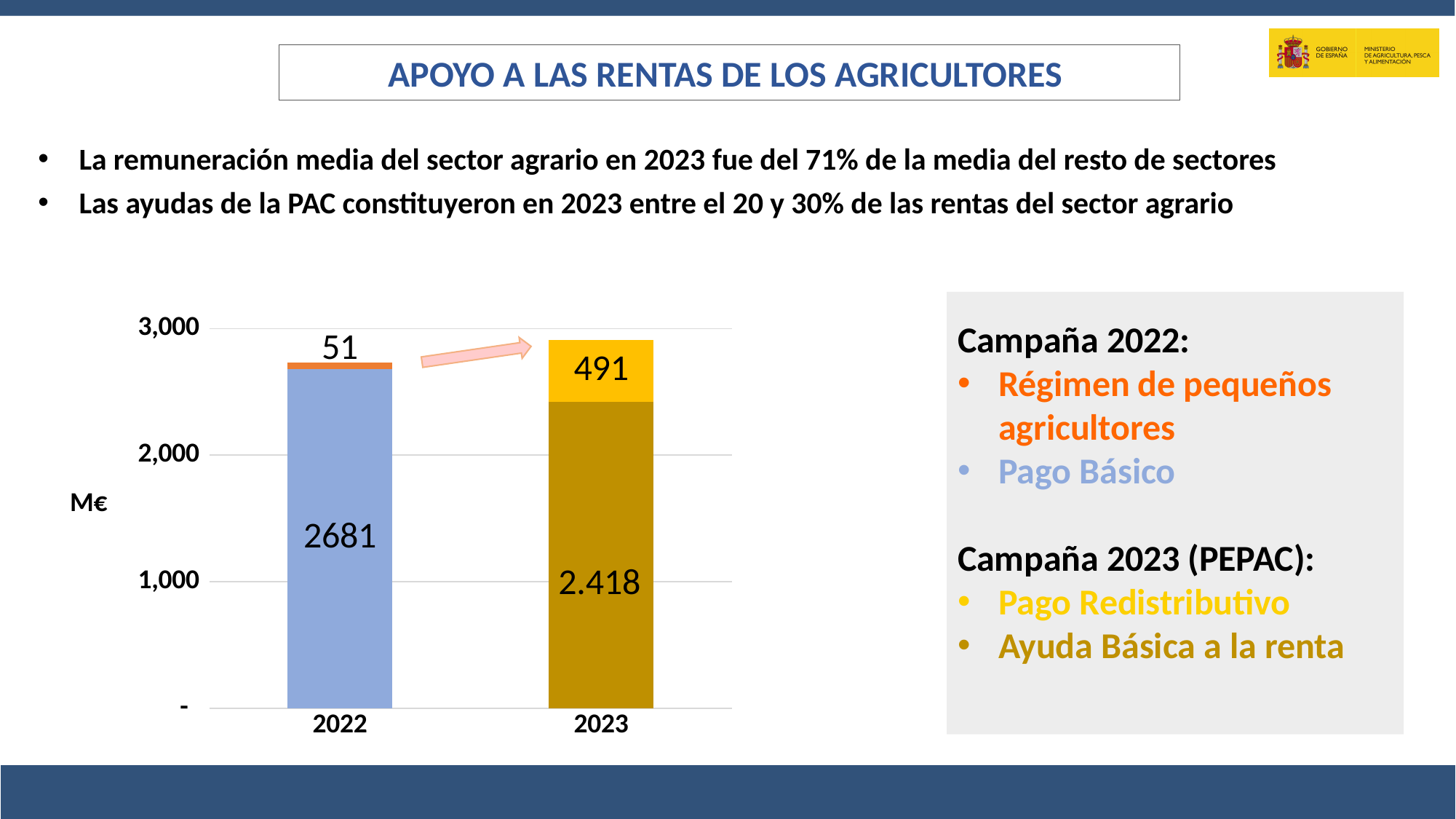
Is the total height of the 2023 bar greater or less than 2,000? greater How many years (categories) are shown on the x axis of the chart? 2 What is the value of the Pago Redistributivo segment for 2023? 491 What is the value of the Régimen de pequeños agricultores segment for 2022? 51 What unit is shown on the y axis of the chart? M€ What is the difference between the Pago Redistributivo value in 2023 (491) and the Régimen de pequeños agricultores value in 2022 (51)? 440 What is the total of the stacked bar for 2022? 2732 What type of chart is shown on the slide? Stacked bar chart What is the value of the Pago Básico segment for 2022? 2681 Which is larger: the Pago Básico segment in 2022 or the Ayuda Básica a la renta segment in 2023? Pago Básico in 2022 Does the total bar height rise or fall from 2022 to 2023? Rises What is the value of the Ayuda Básica a la renta segment for 2023? 2.418